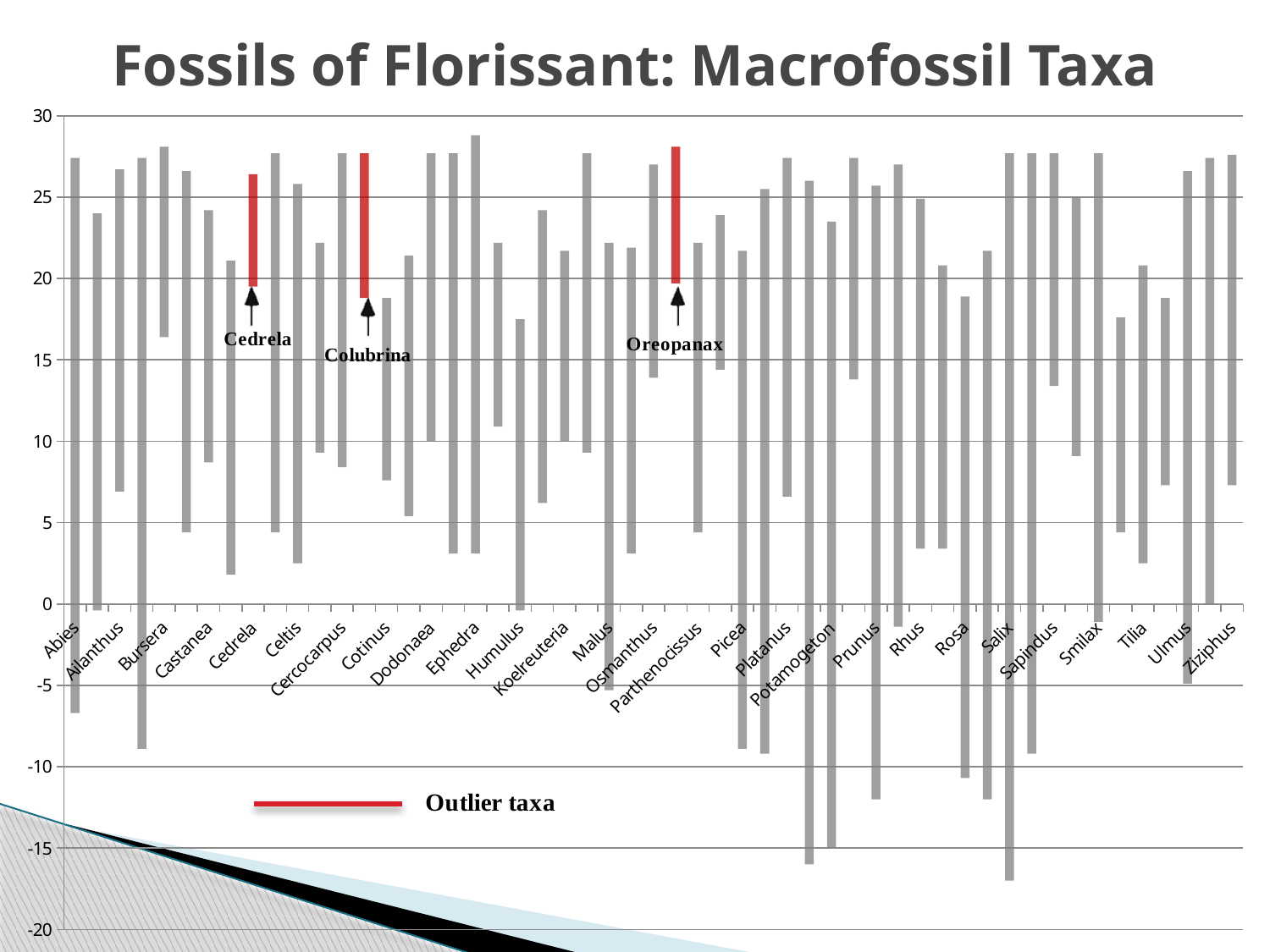
Is the bottom of the red bar for Cedrela greater or less than 15? greater What kind of chart is shown on the slide? bar chart Is the top of the red bar for Colubrina greater or less than 25? greater What is the title of the chart on the slide? Fossils of Florissant: Macrofossil Taxa Is the bottom of the red bar for Colubrina greater or less than 15? greater What is the lowest value shown on the vertical axis? -20 How many bars are highlighted in red as outlier taxa? 3 What does the red bar in the legend represent? Outlier taxa Which three taxa are marked with arrows as outlier taxa? Cedrela, Colubrina, Oreopanax